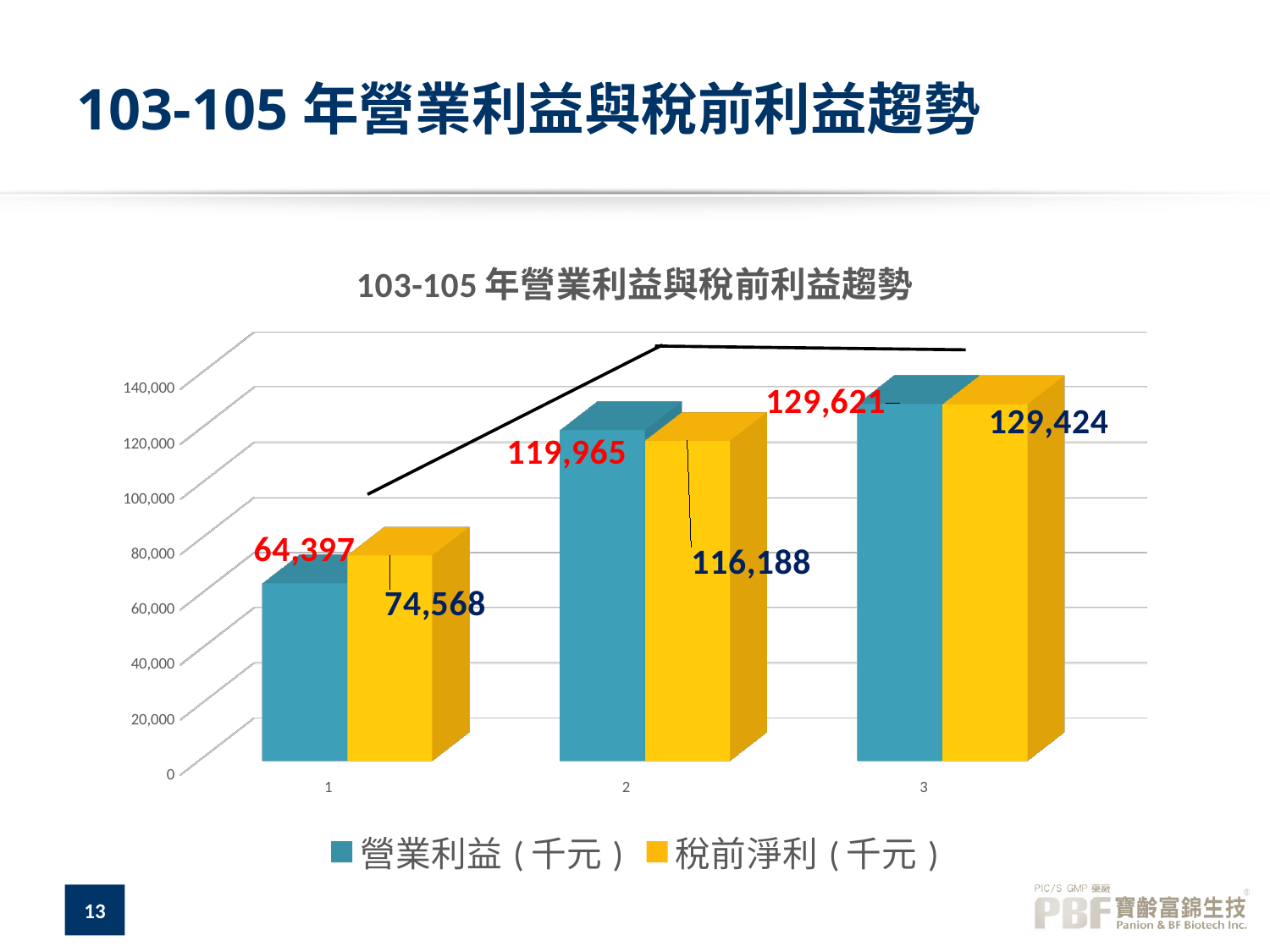
Which category has the highest 營業利益（千元） value? 3 What kind of chart is shown on the slide? bar chart What is the value of 稅前淨利（千元） for category 3? 129,424 How many categories are shown on the x axis? 3 Do the 營業利益（千元） values rise or fall from category 1 to category 3? rise For category 1, which is larger: 營業利益（千元） or 稅前淨利（千元）? 稅前淨利（千元） Which category has the lowest 稅前淨利（千元） value? 1 What is the value of 營業利益（千元） for category 1? 64,397 What is the value of 營業利益（千元） for category 2? 119,965 What is the difference between 營業利益（千元） for category 3 and category 1? 65,224 How many series does the legend list? 2 What is the value of 稅前淨利（千元） for category 2? 116,188